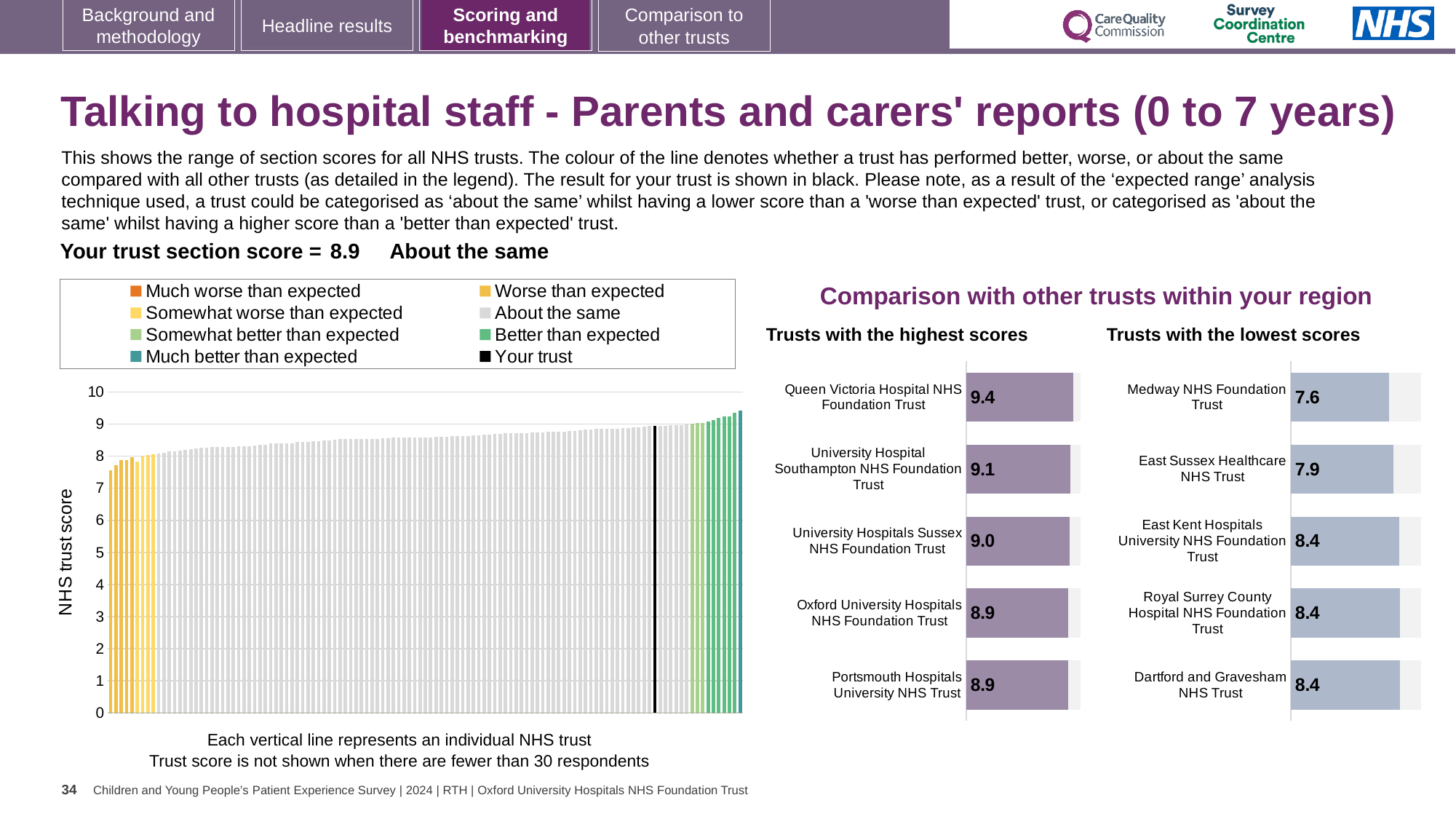
How many trusts are shown in the 'Trusts with the highest scores' chart? 5 In the 'Trusts with the lowest scores' chart, what is the difference between the scores of East Sussex Healthcare NHS Trust and Medway NHS Foundation Trust? 0.3 What kind of chart is the large chart on the left with the y-axis labelled 'NHS trust score'? bar chart In the 'Trusts with the highest scores' chart, what is the score for University Hospitals Sussex NHS Foundation Trust? 9.0 In the 'Trusts with the highest scores' chart, which trust has the highest score? Queen Victoria Hospital NHS Foundation Trust In the 'Trusts with the lowest scores' chart, which has the larger score: Medway NHS Foundation Trust or East Sussex Healthcare NHS Trust? East Sussex Healthcare NHS Trust In the 'Trusts with the highest scores' chart, what is the score for Queen Victoria Hospital NHS Foundation Trust? 9.4 How many entries does the legend of the 'NHS trust score' chart list? 8 In the 'Trusts with the highest scores' chart, what is the difference between the scores of Queen Victoria Hospital NHS Foundation Trust and Oxford University Hospitals NHS Foundation Trust? 0.5 In the 'Trusts with the lowest scores' chart, what is the score for Medway NHS Foundation Trust? 7.6 In the 'Trusts with the lowest scores' chart, which trust has the lowest score? Medway NHS Foundation Trust In the 'NHS trust score' chart, is the value for the lowest-scoring trust (the leftmost bar) greater or less than 8? less